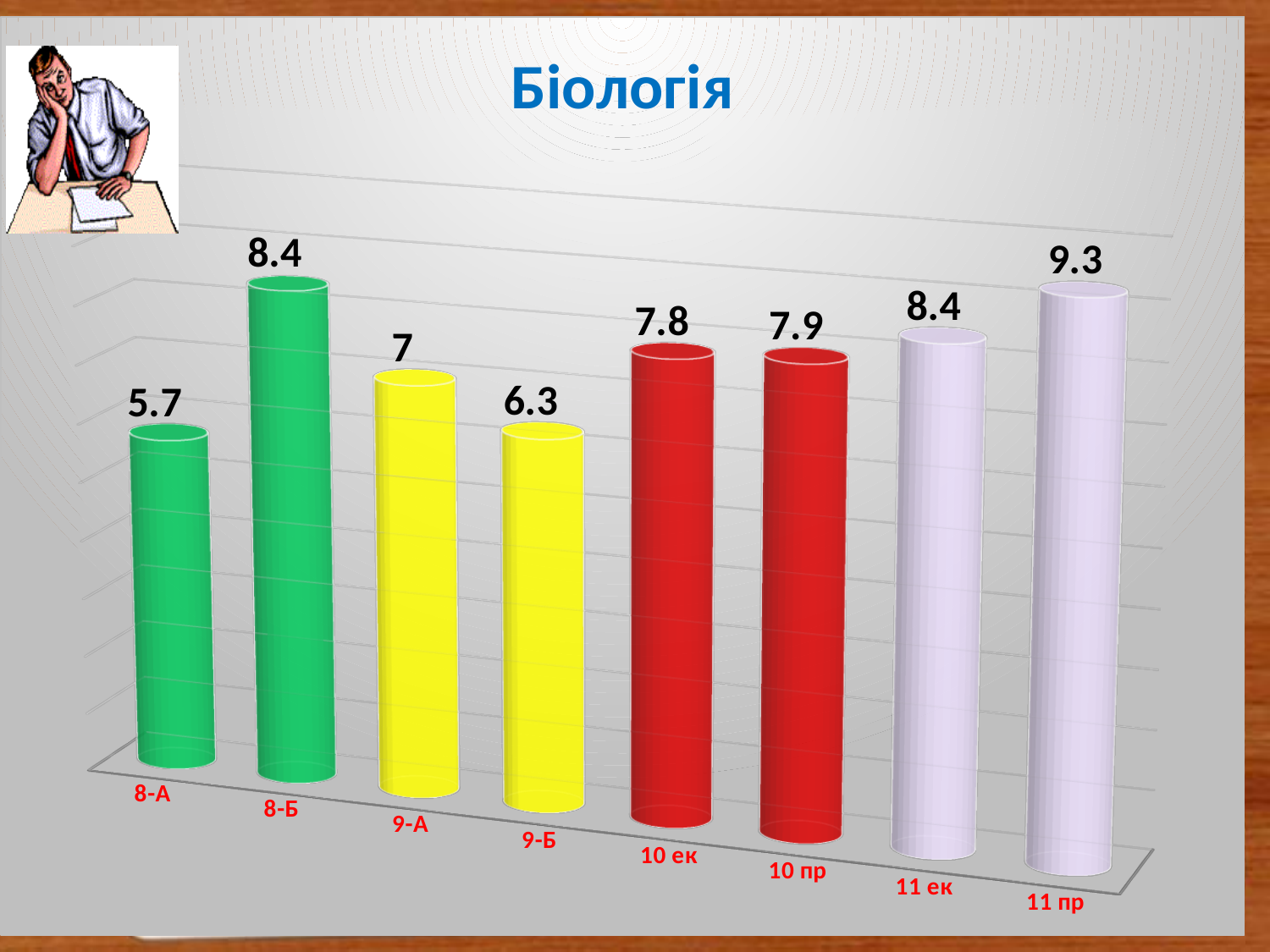
What is the difference between the values for 11 пр and 8-А? 3.6 Which is larger, the value for 10 ек or the value for 10 пр? 10 пр What is the value for 9-Б? 6.3 What is the value for 10 пр? 7.9 What is the value for 8-А? 5.7 What is the difference between the values for 8-Б and 9-А? 1.4 What is the value for 11 ек? 8.4 How many categories are shown in the chart? 8 What is the title of the chart? Біологія Which category has the lowest value? 8-А Which category has the highest value? 11 пр What kind of chart is shown on the slide? bar chart